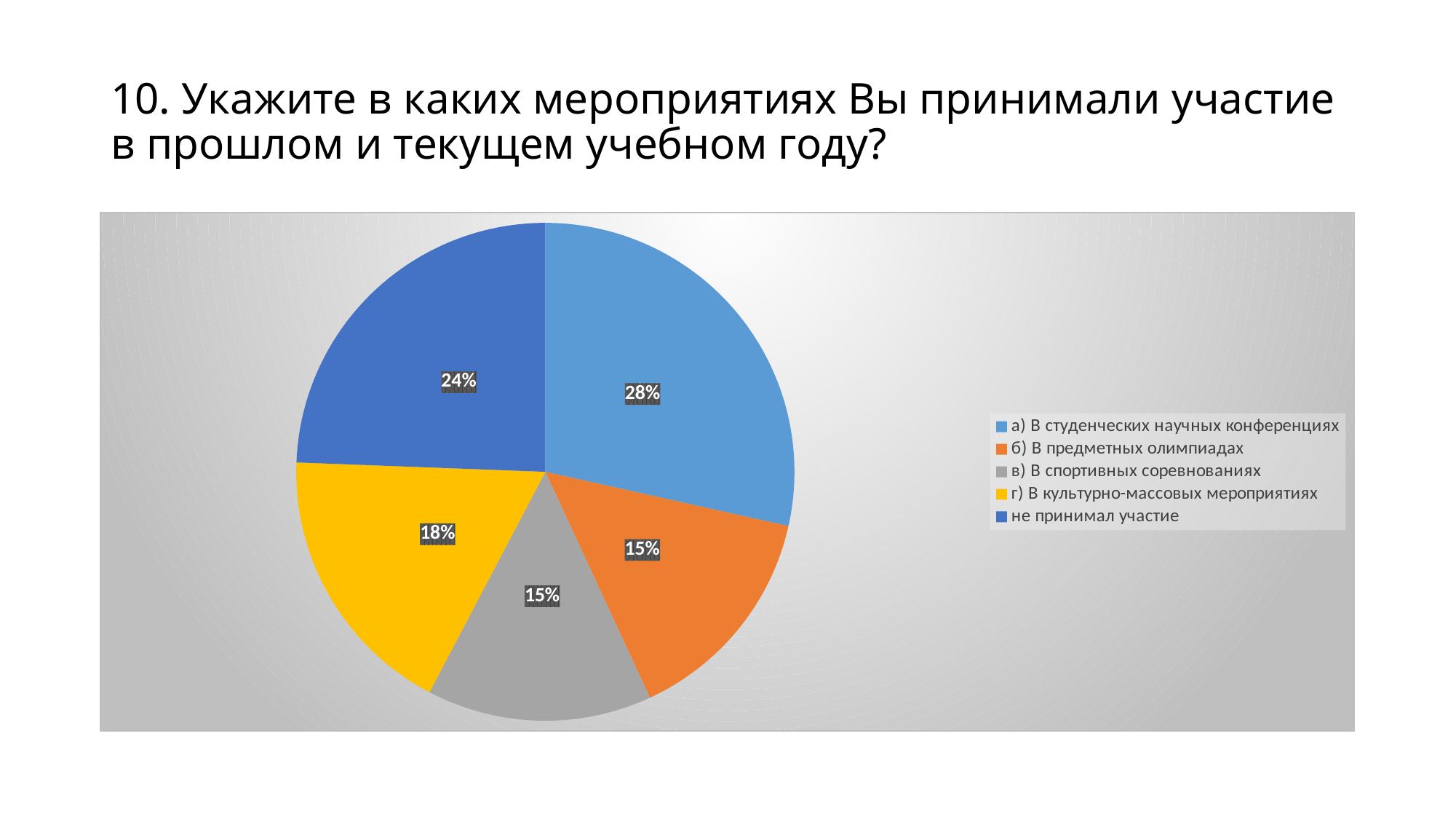
What is the difference in percentage points between "а) В студенческих научных конференциях" and "не принимал участие"? 4 What share of the pie is labelled for "не принимал участие"? 24% Which is larger: the slice for "г) В культурно-массовых мероприятиях" or the slice for "б) В предметных олимпиадах"? г) В культурно-массовых мероприятиях What colour is the slice for "г) В культурно-массовых мероприятиях"? yellow Which category has the largest slice of the pie? а) В студенческих научных конференциях What type of chart is shown on the slide? pie chart What share of the pie is labelled for "б) В предметных олимпиадах"? 15% How many slices does the pie chart have? 5 How many entries does the legend list? 5 What share of the pie is labelled for "а) В студенческих научных конференциях"? 28% What share of the pie is labelled for "в) В спортивных соревнованиях"? 15% What share of the pie is labelled for "г) В культурно-массовых мероприятиях"? 18%